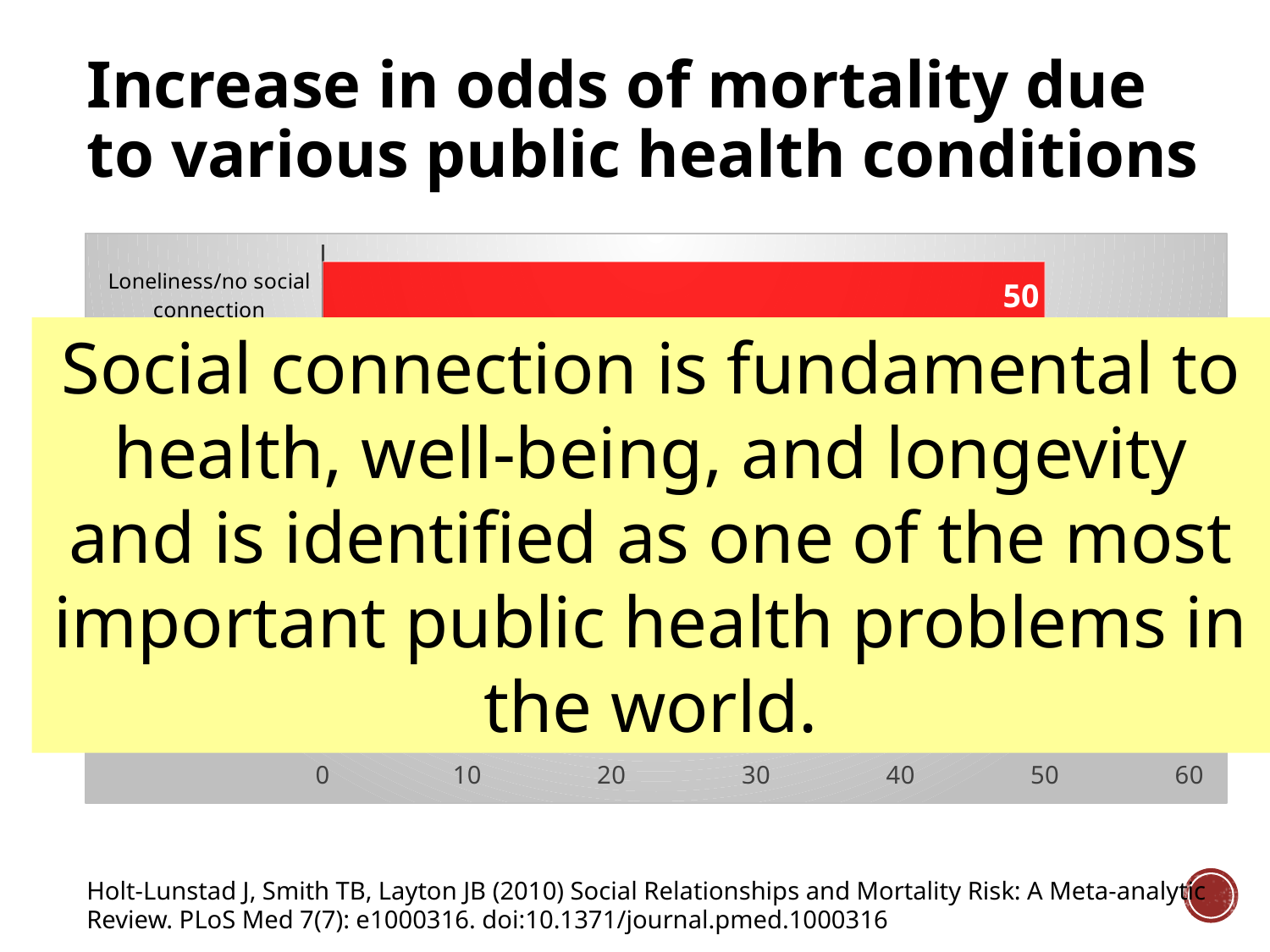
What is the highest tick value shown on the horizontal axis of the chart? 60 Is the value for Loneliness/no social connection greater or less than 40? greater What kind of chart is shown on the slide? bar chart What colour is the bar for Loneliness/no social connection? red What is the value shown for Loneliness/no social connection? 50 Is the value for Loneliness/no social connection greater or less than 60? less